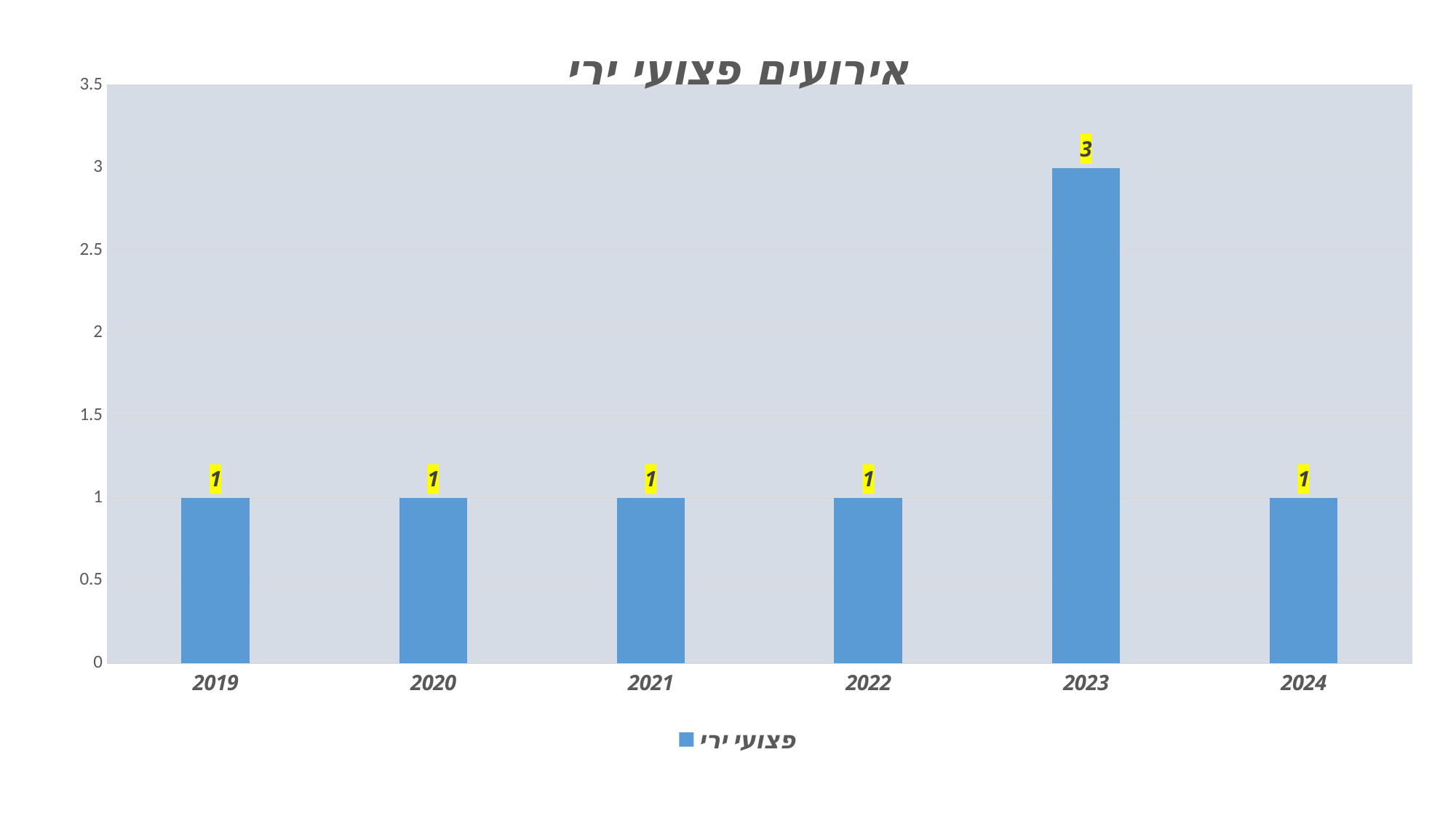
What is the value for 2019? 1 What is the value for 2023? 3 Is the value for 2023 greater or less than 2? greater Which is larger, the value for 2023 or the value for 2021? 2023 Which year has the highest value? 2023 What is the legend entry for the series? פצועי ירי How many years are shown on the x axis? 6 What is the value for 2024? 1 What kind of chart is shown? bar chart What is the title of the chart? אירועים פצועי ירי How many series does the legend list? 1 What is the difference between the values for 2023 and 2022? 2